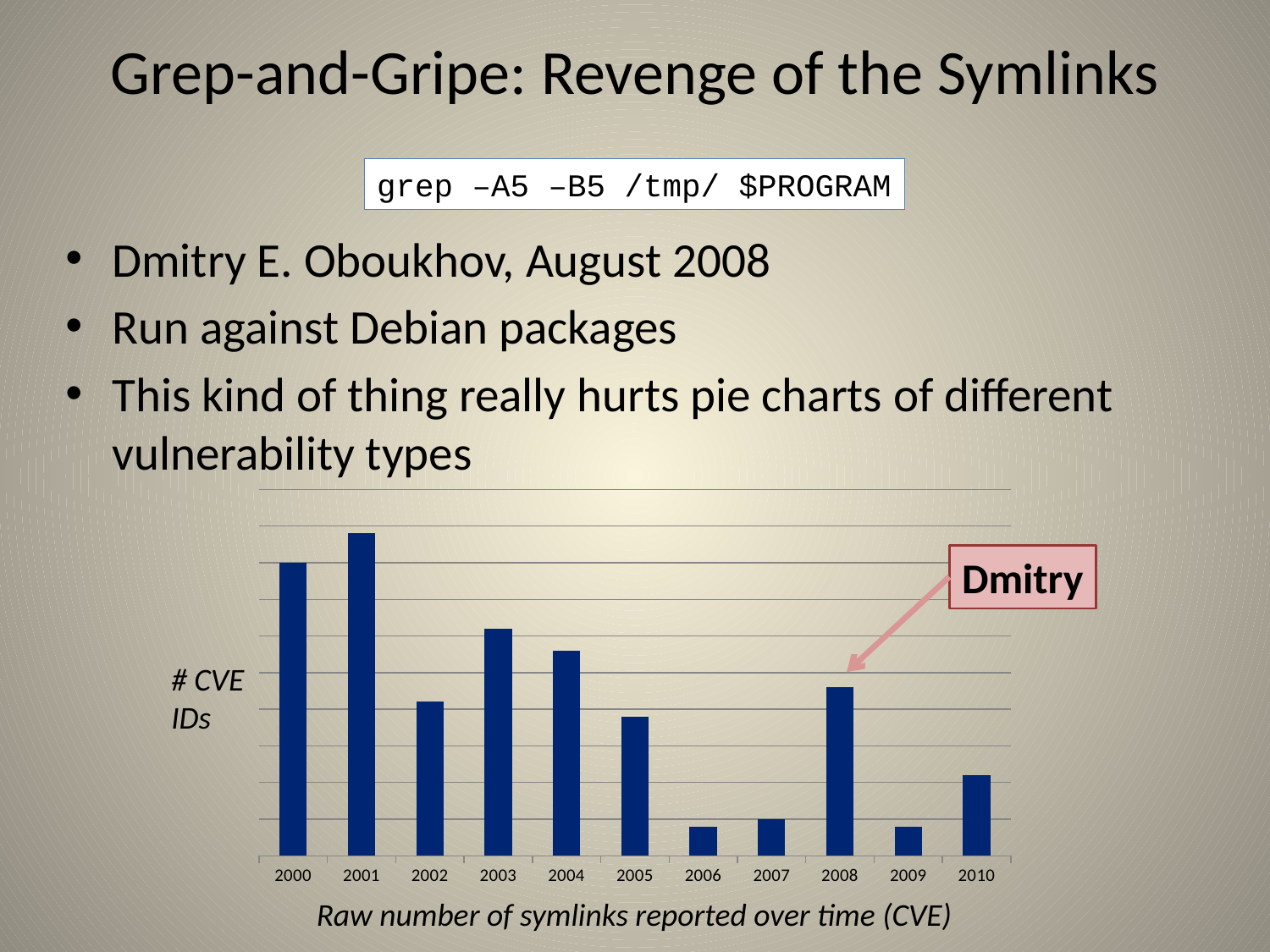
What is the label on the vertical axis of the chart? # CVE IDs Do the values in the chart generally rise or fall from 2001 to 2006? fall Which year has the higher value in the chart, 2008 or 2010? 2008 Which year has the higher value in the chart, 2000 or 2005? 2000 Which year has the higher value in the chart, 2007 or 2010? 2010 Which year has the highest number of CVE IDs in the chart? 2001 Which year's bar does the 'Dmitry' annotation arrow point to? 2008 What kind of chart is shown on the slide? bar chart How many years are shown on the x axis of the chart? 11